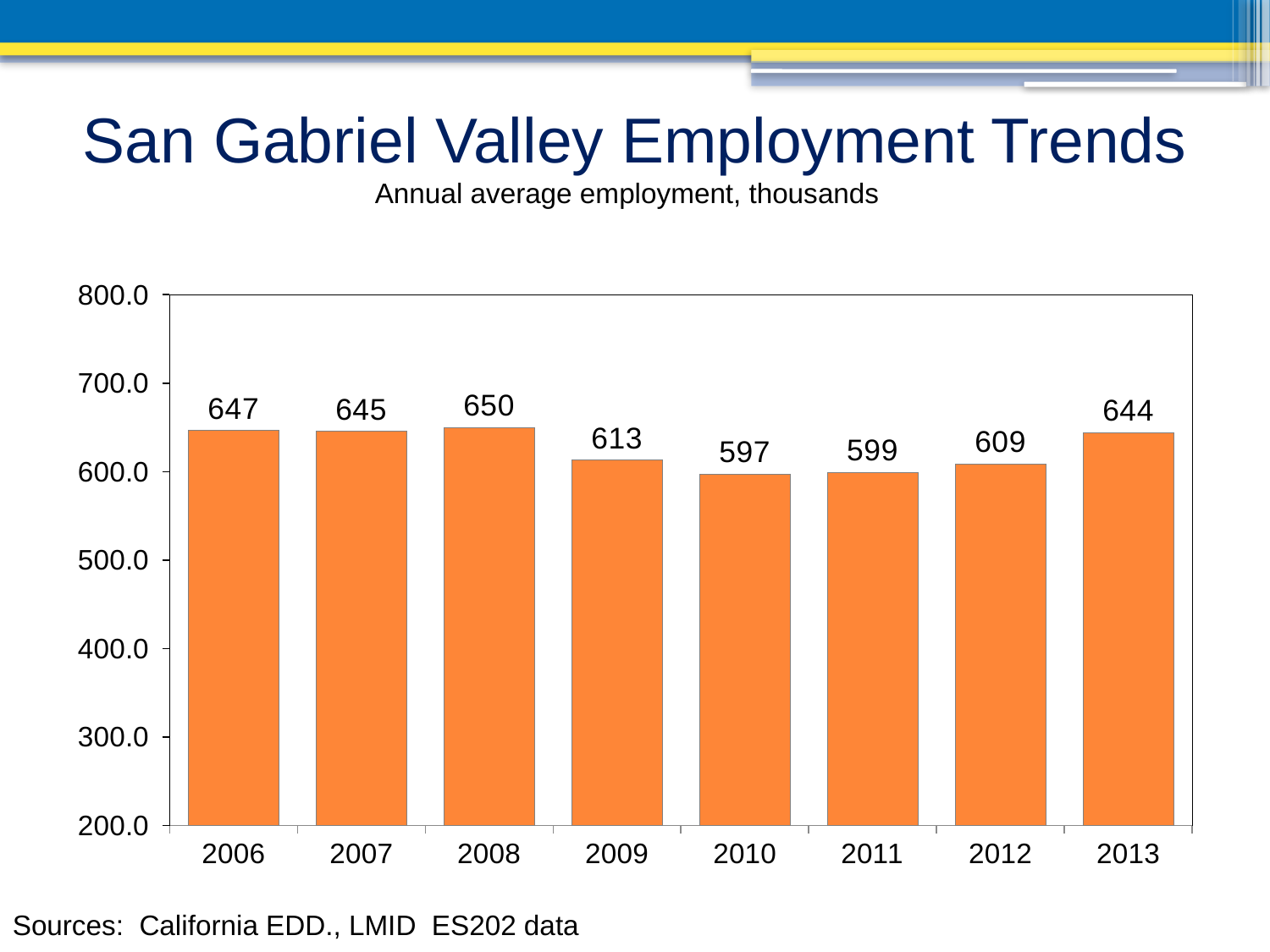
Which year has the larger value, 2009 or 2012? 2009 What is the annual average employment value shown for 2008? 650 Which year has the highest annual average employment? 2008 What kind of chart is shown on the slide? bar chart What is the difference between the 2008 value and the 2010 value? 53 Is the value for 2011 greater or less than 600.0? less What is the annual average employment value shown for 2010? 597 What is the annual average employment value shown for 2013? 644 What is the difference between the 2006 value and the 2009 value? 34 How many years are shown on the x axis? 8 Which year has the lowest annual average employment? 2010 What unit does the subtitle say the employment values are in? thousands